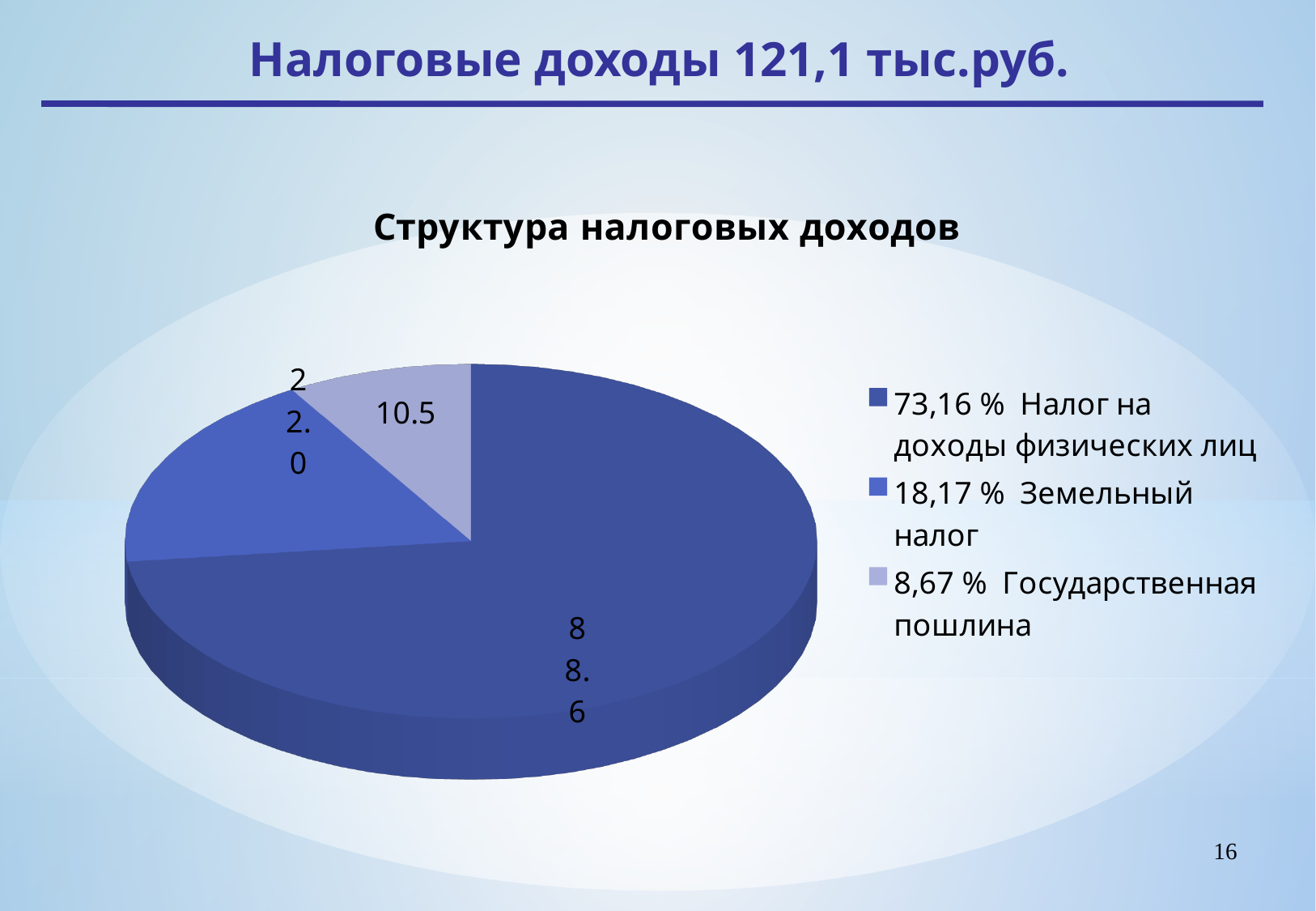
What is the value shown for Налог на доходы физических лиц? 88.6 What share of the pie does Земельный налог represent, according to the legend? 18,17 % Which category has the smallest slice of the pie? Государственная пошлина What is the value shown for Государственная пошлина? 10.5 What is the value shown for Земельный налог? 22.0 What is the difference between the values for Налог на доходы физических лиц and Земельный налог? 66.6 What is the title of the chart? Структура налоговых доходов How many slices does the pie chart have? 3 What share of the pie does Государственная пошлина represent, according to the legend? 8,67 % Which is larger, the value for Земельный налог or the value for Государственная пошлина? Земельный налог What kind of chart is shown on the slide? pie chart Which category has the largest slice of the pie? Налог на доходы физических лиц